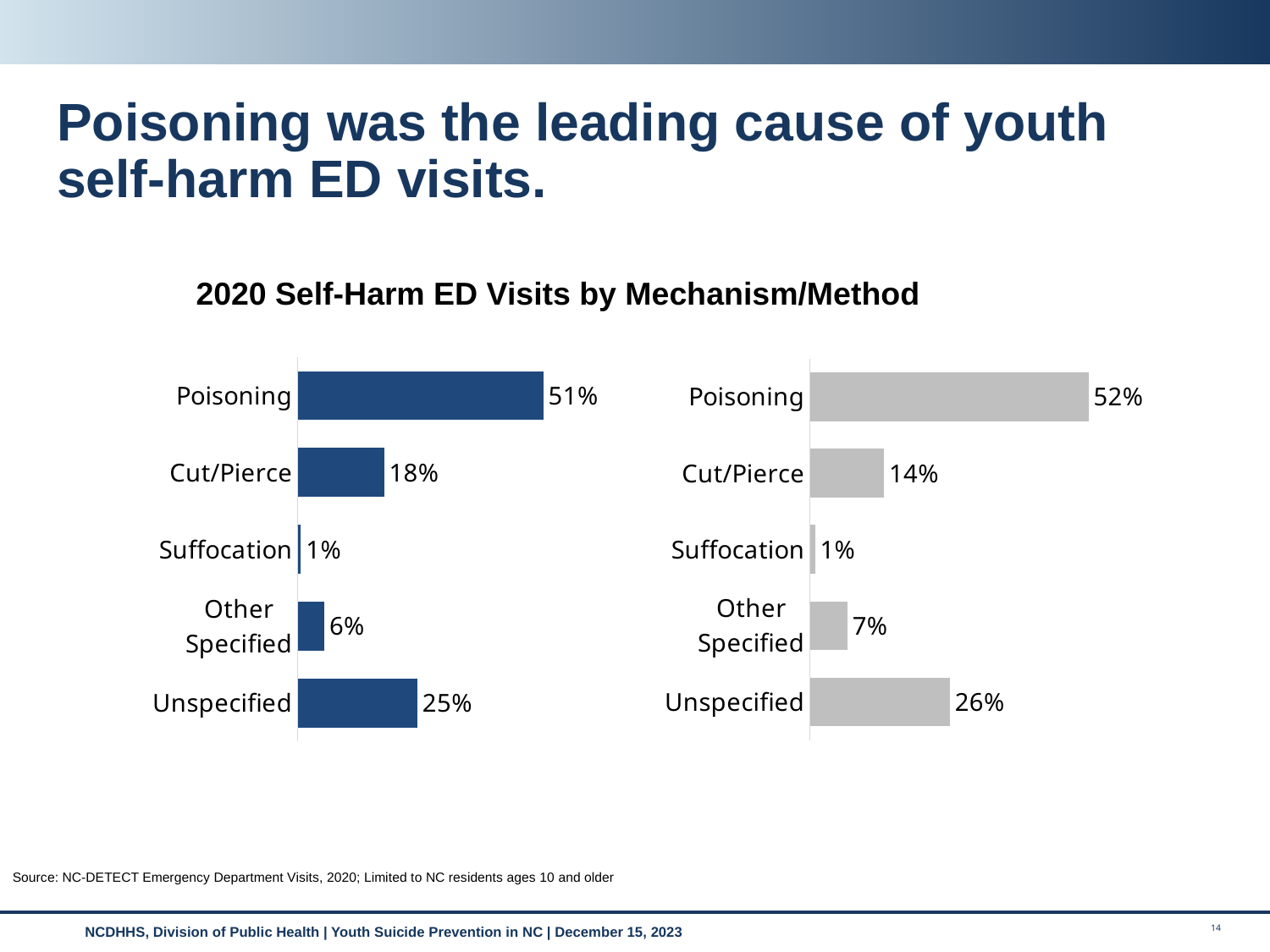
In the right chart, what is the value for Cut/Pierce? 14% In the right chart, which category has the highest value? Poisoning In the left chart, what is the value for Poisoning? 51% What is the title shown above the two charts? 2020 Self-Harm ED Visits by Mechanism/Method In the left chart, what is the value for Unspecified? 25% In the right chart, what is the difference between the values for Unspecified and Cut/Pierce? 12% In the left chart, which is larger, the value for Cut/Pierce or the value for Other Specified? Cut/Pierce In the right chart, what is the value for Other Specified? 7% In the left chart, what is the difference between the values for Poisoning and Unspecified? 26% What kind of chart is the left chart? Bar chart How many categories are shown in the right chart? 5 In the left chart, which category has the lowest value? Suffocation